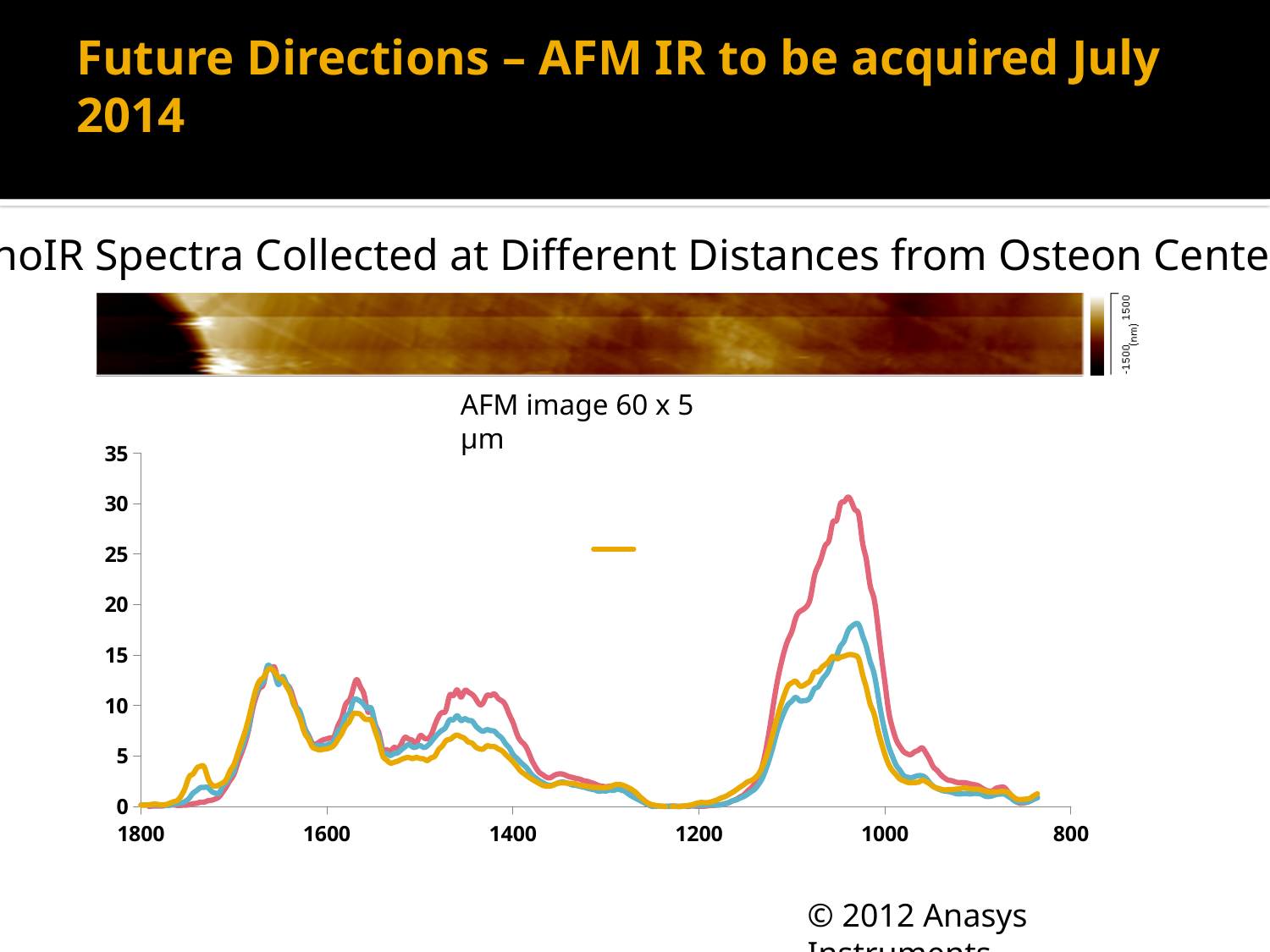
Is the peak of the orange line near 1030 on the x axis greater or less than 20? less Which line reaches the highest value on the chart? the pink line Is the peak of the blue line near 1030 on the x axis greater or less than 15? greater Is the peak of the pink line near 1650 on the x axis greater or less than 10? greater What kind of chart is shown on the slide? line chart What is the highest tick value shown on the y axis? 35 Near 1030 on the x axis, which line has the larger value, the pink line or the orange line? the pink line What are the leftmost and rightmost tick values on the x axis? 1800 and 800 How many lines are plotted on the chart? 3